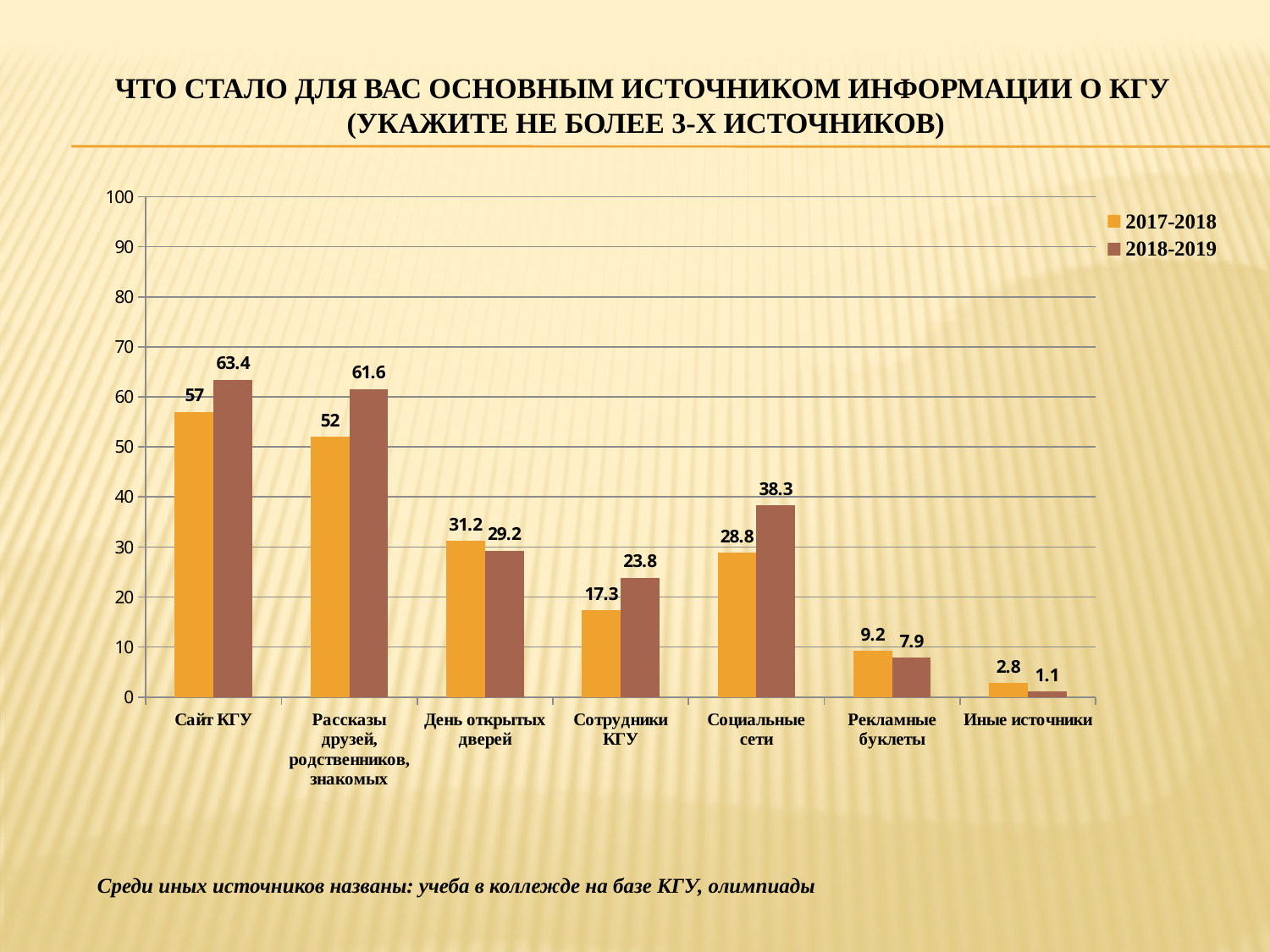
Which series is shown in orange in the legend? 2017-2018 How many categories are shown on the x axis? 7 Which category has the lowest value in the 2018-2019 series? Иные источники Is the 2018-2019 value for Рассказы друзей, родственников, знакомых greater or less than 60? greater What is the value for Сайт КГУ in the 2018-2019 series? 63.4 How many series does the legend list? 2 Which category has the highest value in the 2017-2018 series? Сайт КГУ What is the value for Рекламные буклеты in the 2018-2019 series? 7.9 What is the difference between the 2018-2019 and 2017-2018 values for Сотрудники КГУ? 6.5 What kind of chart is shown on the slide? bar chart What is the value for Социальные сети in the 2017-2018 series? 28.8 Which is larger for День открытых дверей: the 2017-2018 value or the 2018-2019 value? 2017-2018